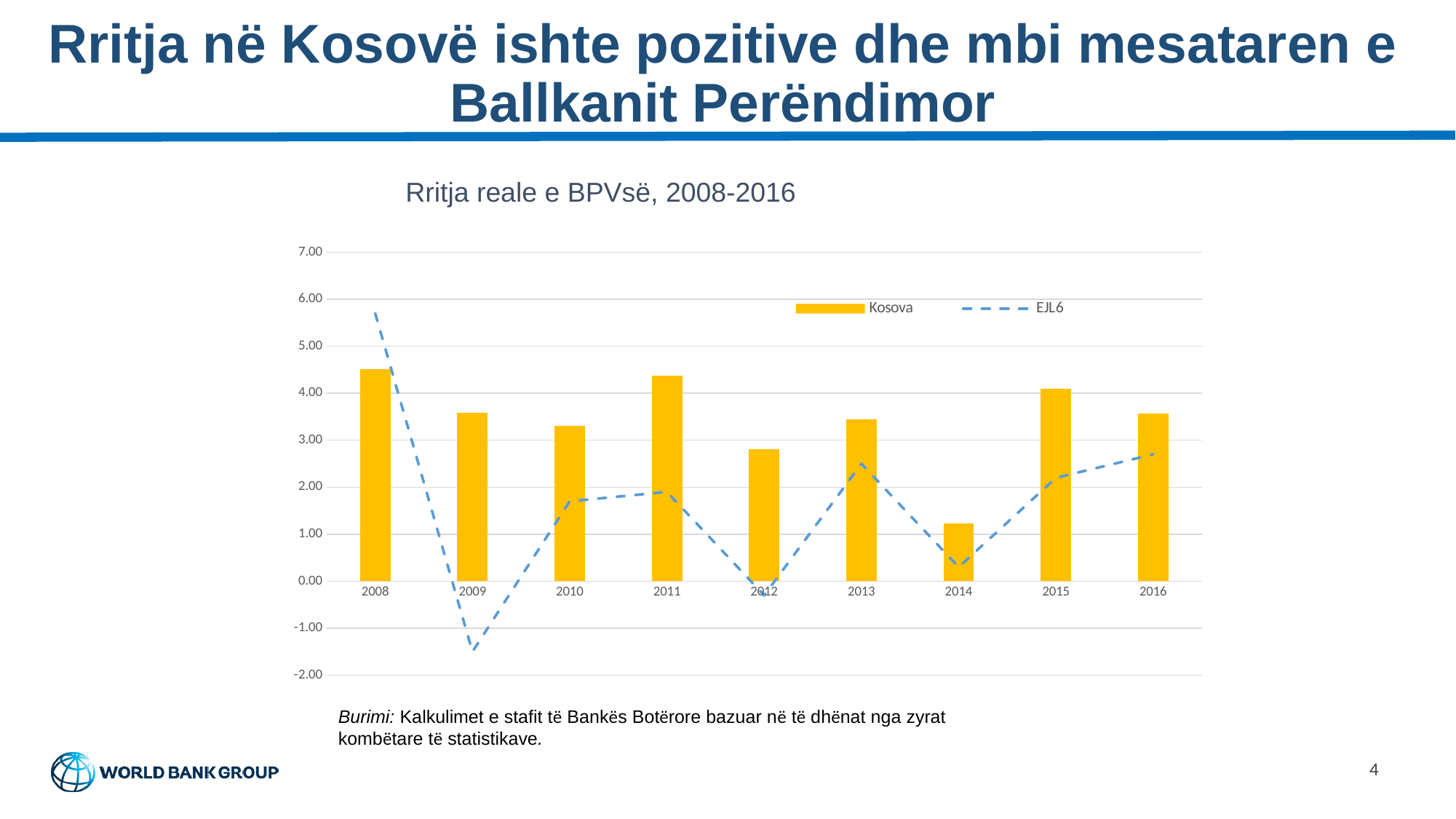
Is the Kosova value for 2008 greater or less than 4.00? greater What kind of chart is used to show the Kosova series? bar chart Which series is drawn as a dashed line? EJL6 What is the title of the chart? Rritja reale e BPVsë, 2008-2016 Is the Kosova value for 2014 greater or less than 2.00? less Which is larger, the Kosova value for 2012 or for 2014? 2012 How many years are shown on the x axis of the chart? 9 Is the EJL6 value for 2009 greater or less than 0.00? less In which year is the Kosova bar the lowest? 2014 How many series does the legend list? 2 In which year is the EJL6 value the highest? 2008 In which year is the EJL6 value the lowest? 2009